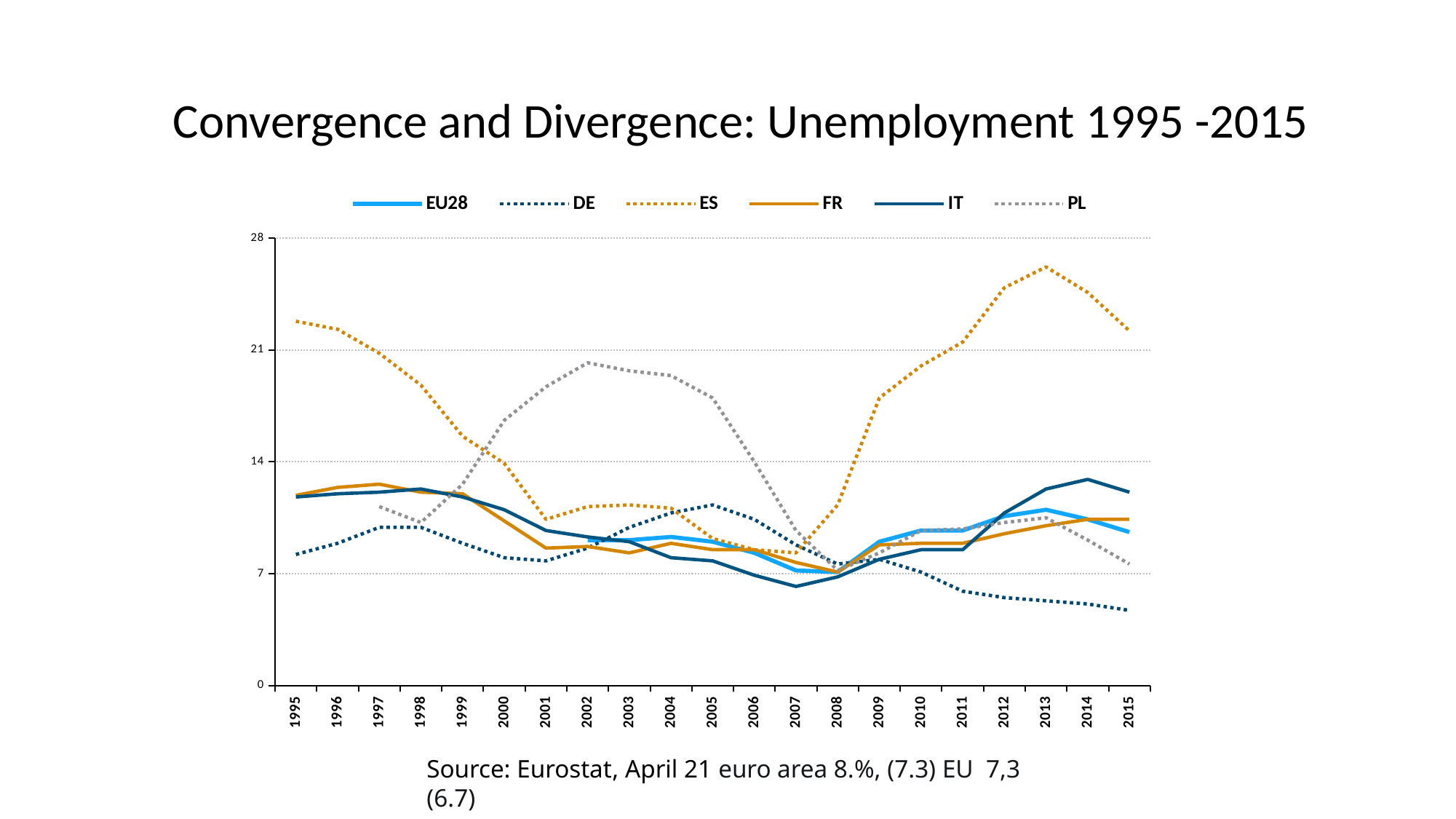
How many series does the legend list? 6 Is the value for DE in 2015 greater or less than 7? less Is the value for ES in 2013 greater or less than 21? greater What is the title of the chart on the slide? Convergence and Divergence: Unemployment 1995 -2015 Which series has the lowest value in 2015? DE Which series has the highest value in 2013? ES Which series has the highest value in 2002? PL How many years are plotted along the x axis? 21 Is the value for PL in 2002 greater or less than 14? greater Does the DE series rise or fall between 2005 and 2015? fall What kind of chart is shown on the slide? line chart Which is larger in 1995, the value for ES or the value for DE? ES